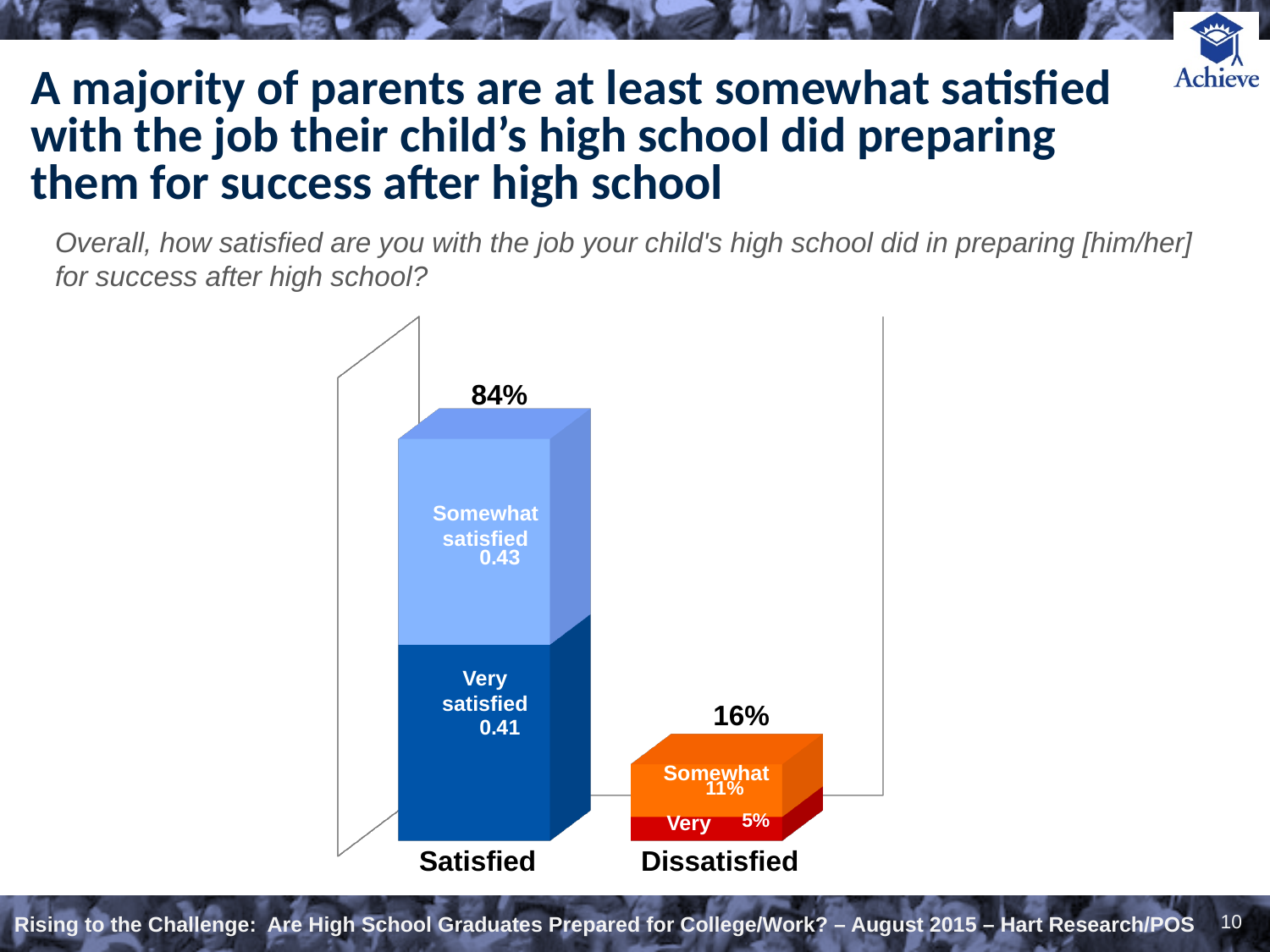
What kind of chart is shown on the slide? Stacked bar chart What colour is the Very satisfied segment of the Satisfied bar? Dark blue How many categories are shown on the x axis of the chart? 2 What value is printed on the Very segment of the Dissatisfied bar? 5% What is the difference between the Satisfied total and the Dissatisfied total? 68% What total percentage is shown above the Satisfied bar? 84% What value is printed on the Somewhat satisfied segment of the Satisfied bar? 0.43 What value is printed on the Very satisfied segment of the Satisfied bar? 0.41 What total percentage is shown above the Dissatisfied bar? 16% Within the Dissatisfied bar, which segment is larger, Somewhat or Very? Somewhat What value is printed on the Somewhat segment of the Dissatisfied bar? 11% Which category has the higher total, Satisfied or Dissatisfied? Satisfied